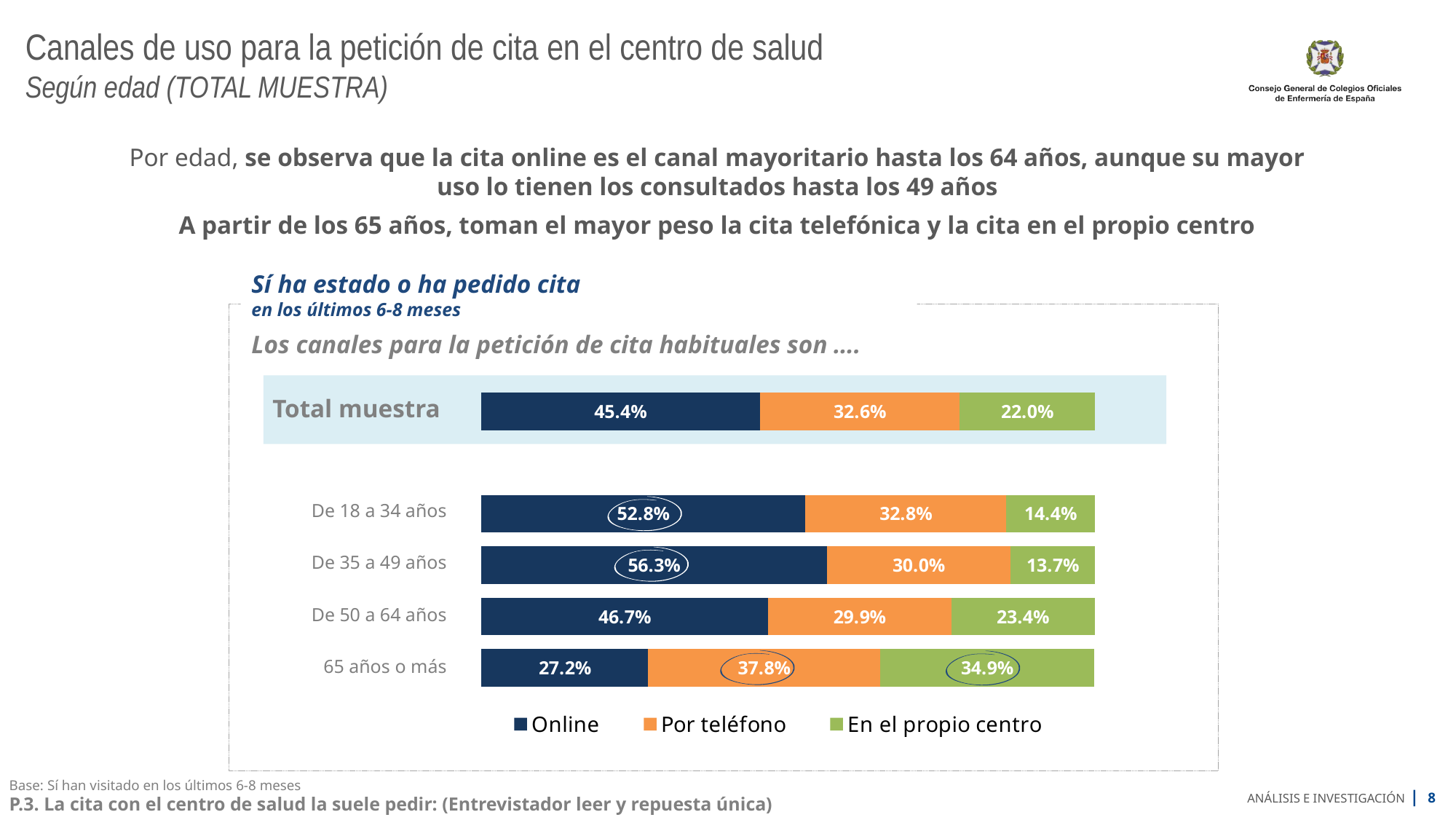
What kind of chart is shown on the slide? Stacked bar chart How many age groups are shown below the Total muestra bar? 4 Which colour represents 'Por teléfono' in the chart? Orange What percentage of respondents aged 35 to 49 (De 35 a 49 años) request appointments online? 56.3% What is the 'Por teléfono' value for the 65 años o más group? 37.8% How many series does the legend list? 3 Which age group has the lowest 'En el propio centro' share? De 35 a 49 años What is the difference in percentage points between the 'Online' values for De 35 a 49 años and De 18 a 34 años? 3.5 For the 65 años o más group, which is larger: 'Por teléfono' or 'Online'? Por teléfono What is the 'En el propio centro' value for the Total muestra bar? 22.0% Which age group has the highest 'Online' share? De 35 a 49 años What is the total of the stacked bar for De 18 a 34 años? 100.0%